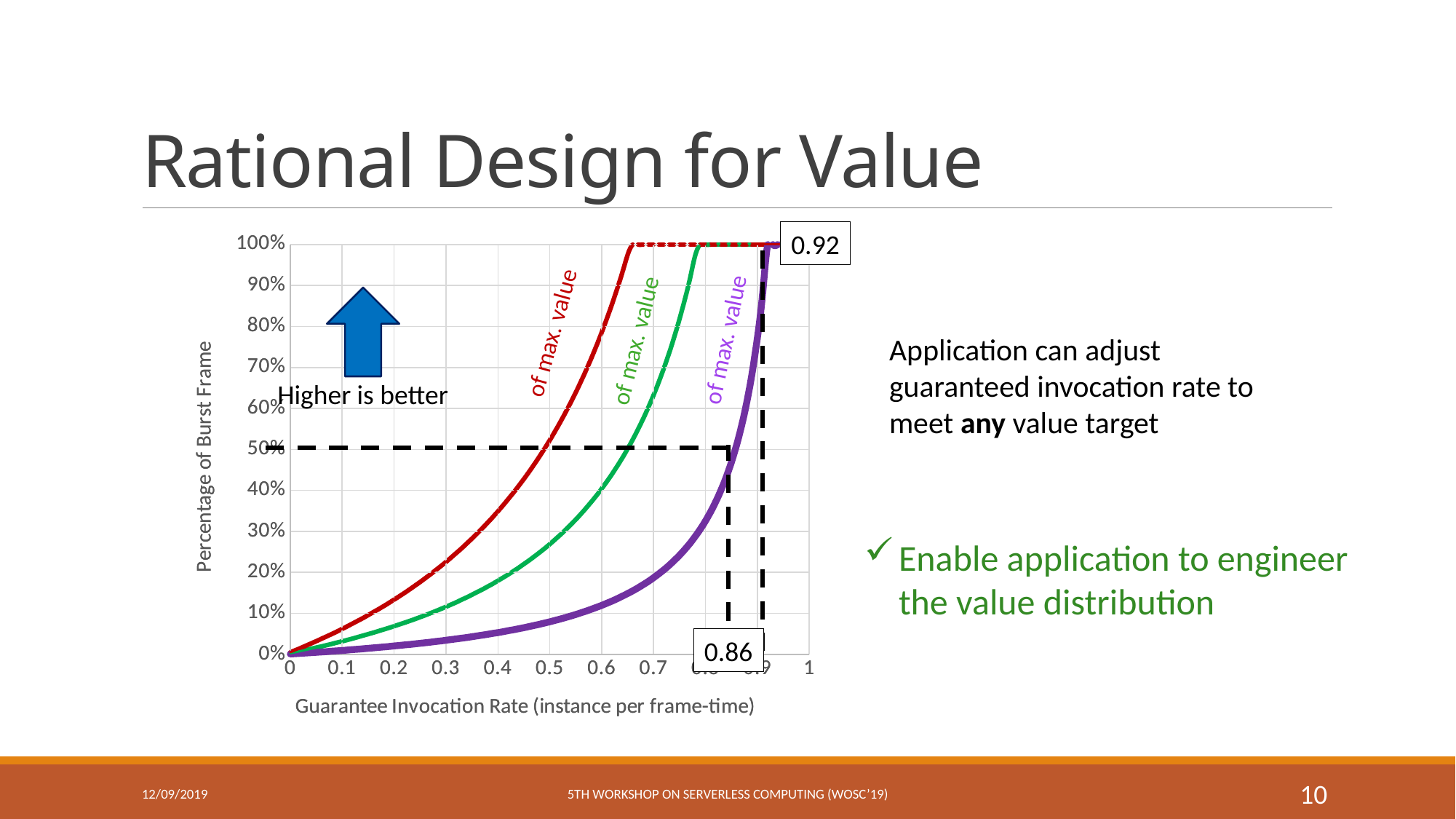
Is the value of the purple curve at a guarantee invocation rate of 0.5 greater or less than 20%? less Is the value of the green curve at a guarantee invocation rate of 0.7 greater or less than 60%? greater What type of chart is shown on the slide? line chart What is the title of the y axis of the chart? Percentage of Burst Frame What value is shown in the annotation box at the top right of the chart? 0.92 How many curves are plotted on the chart? 3 What value is shown in the annotation box near the bottom of the chart? 0.86 What is the title of the x axis of the chart? Guarantee Invocation Rate (instance per frame-time) Is the value of the red curve at a guarantee invocation rate of 0.3 greater or less than 30%? less Which curve reaches 100% at the lowest guarantee invocation rate? the red curve Do the curves rise or fall as the guarantee invocation rate increases? rise At a guarantee invocation rate of 0.5, which curve is higher, the red one or the purple one? the red one